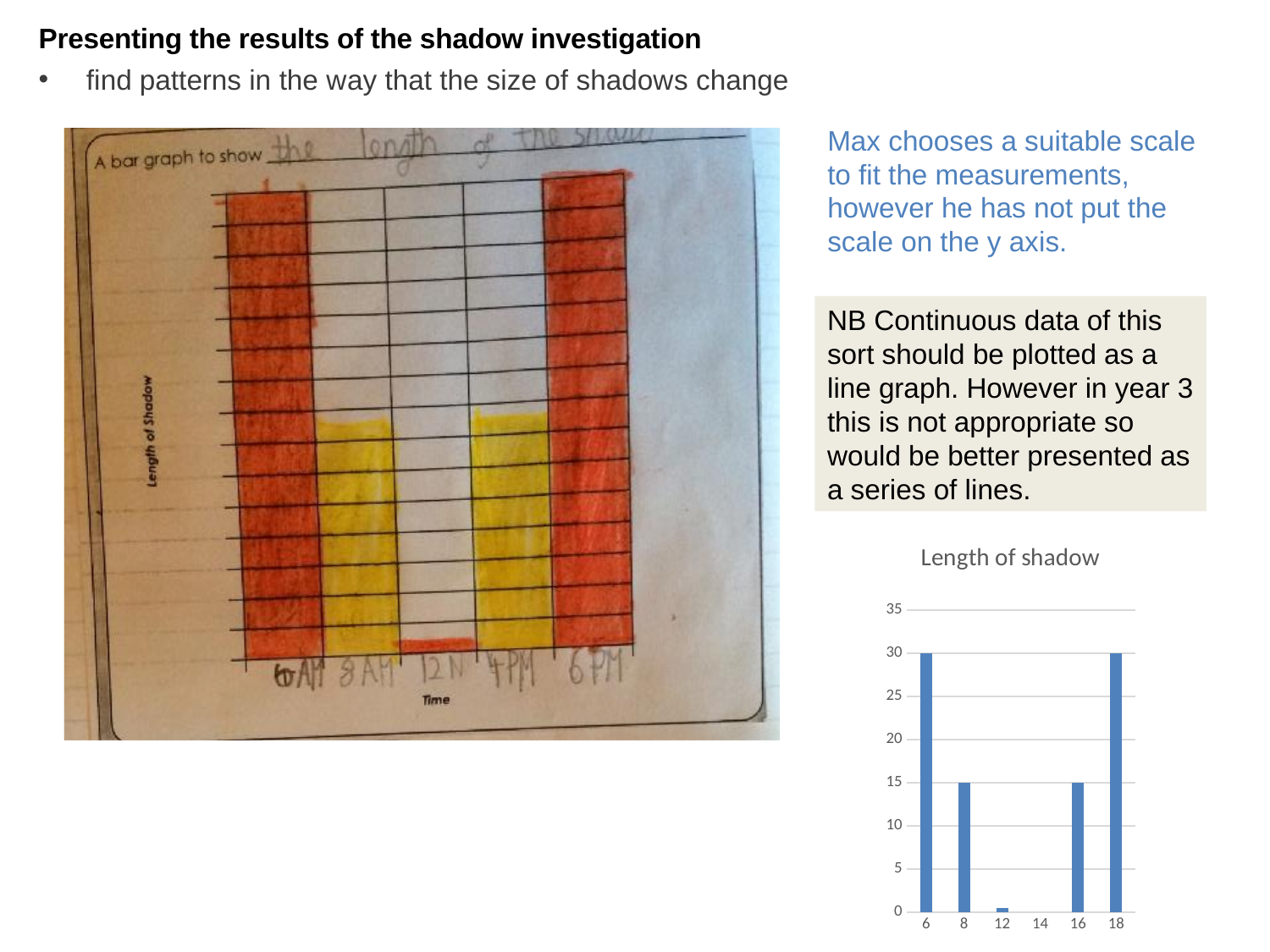
In the hand-drawn chart on the left, what is the label on the x axis? Time In the 'Length of shadow' chart on the right, is the value for 12 greater or less than 5? less In the 'Length of shadow' chart on the right, which has the larger value, 6 or 16? 6 In the hand-drawn chart on the left, which time has the shortest bar? 12N In the 'Length of shadow' chart on the right, what is the value for 18? 30 In the 'Length of shadow' chart on the right, what is the value for 6? 30 In the 'Length of shadow' chart on the right, how many categories are labelled on the x axis? 6 In the 'Length of shadow' chart on the right, do the values rise or fall from 6 to 12 along the x axis? fall In the hand-drawn chart on the left, how many time categories are shown on the x axis? 5 In the 'Length of shadow' chart on the right, what is the value for 8? 15 In the 'Length of shadow' chart on the right, what is the difference between the values for 6 and 8? 15 What kind of chart is the 'Length of shadow' chart on the right? bar chart